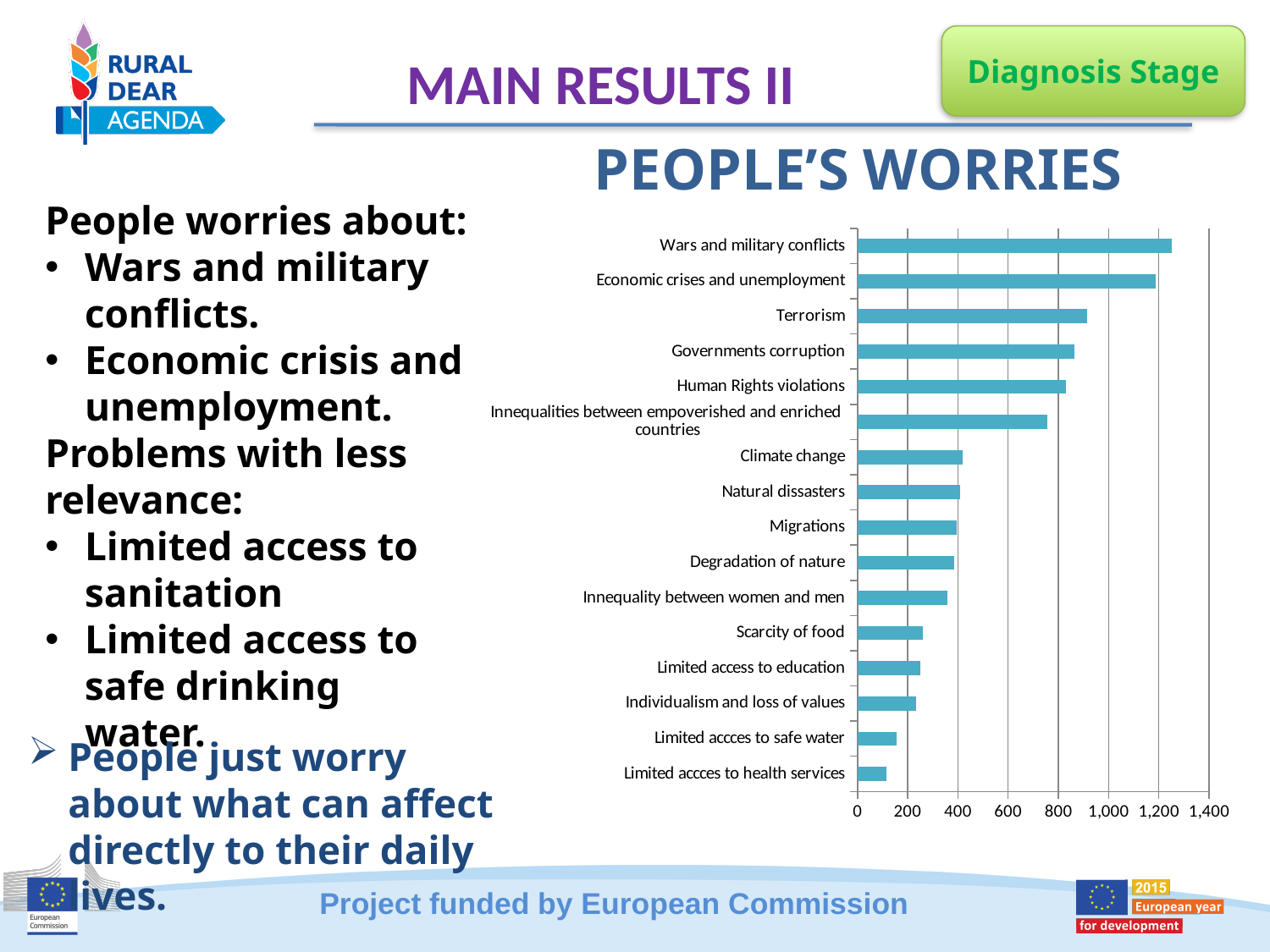
Is the value for Terrorism greater or less than 1,000? less How many categories are plotted in the chart? 16 What is the title of the chart? PEOPLE'S WORRIES Is the value for Wars and military conflicts greater or less than 1,200? greater Which category has the highest value in the chart? Wars and military conflicts Which has a larger value, Migrations or Limited access to education? Migrations What is the highest value shown on the horizontal axis of the chart? 1,400 Which has a larger value, Governments corruption or Scarcity of food? Governments corruption Which category has the lowest value in the chart? Limited accces to health services Is the value for Limited acces to safe water greater or less than 200? less What kind of chart is shown on the slide? bar chart